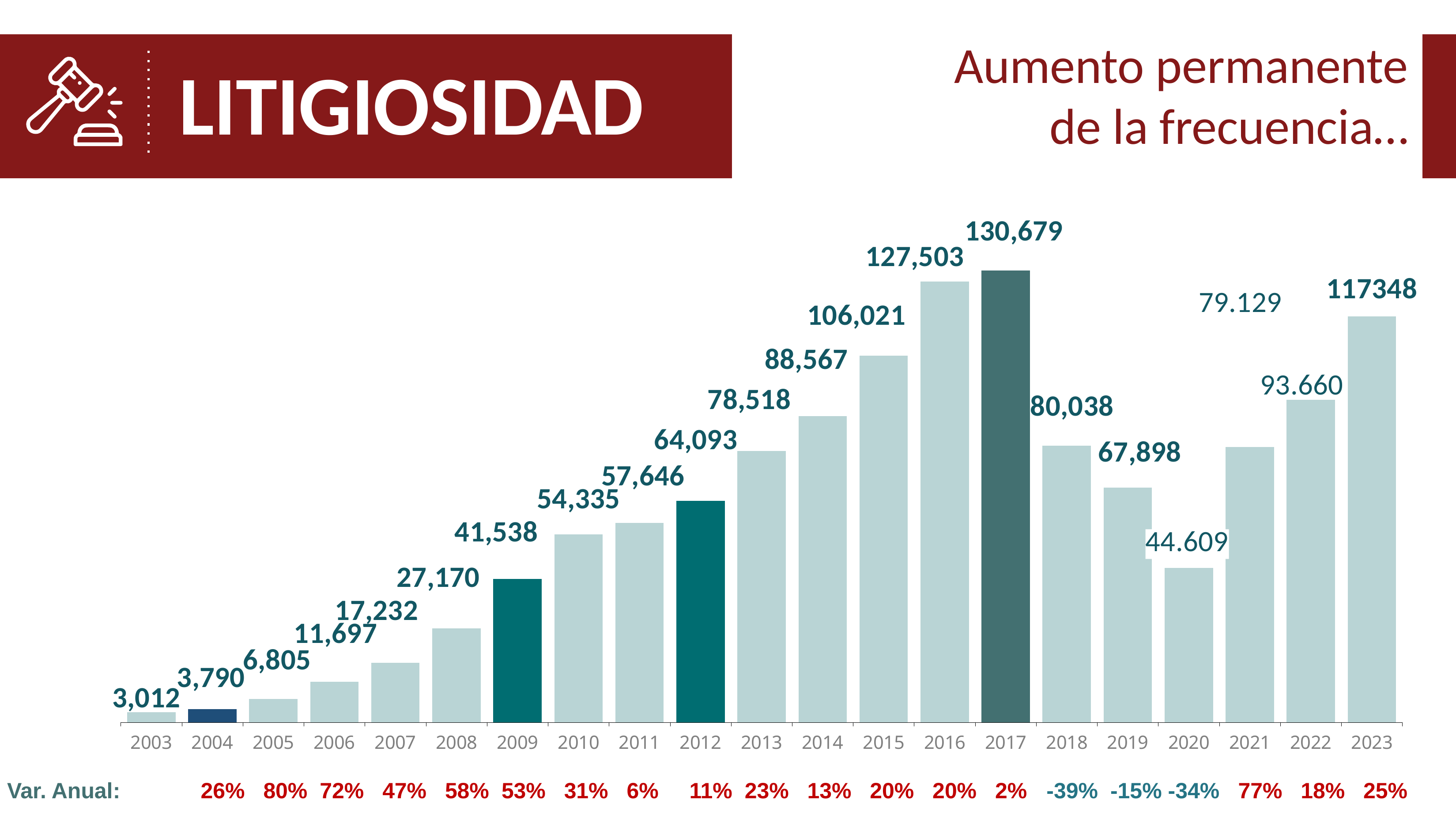
What is the value for 2020? 44.609 What is the 'Var. Anual' percentage shown for 2018? -39% Which is larger, the value for 2018 or the value for 2021? 2018 What is the difference between the values for 2017 and 2016? 3,176 Which year has the highest value? 2017 What kind of chart is shown on the slide? Bar chart Do the values rise or fall from 2003 to 2017? Rise Which year has the lowest value? 2003 What is the value for 2017? 130,679 What is the value for 2023? 117348 How many years are shown on the x axis? 21 What is the value for 2003? 3,012